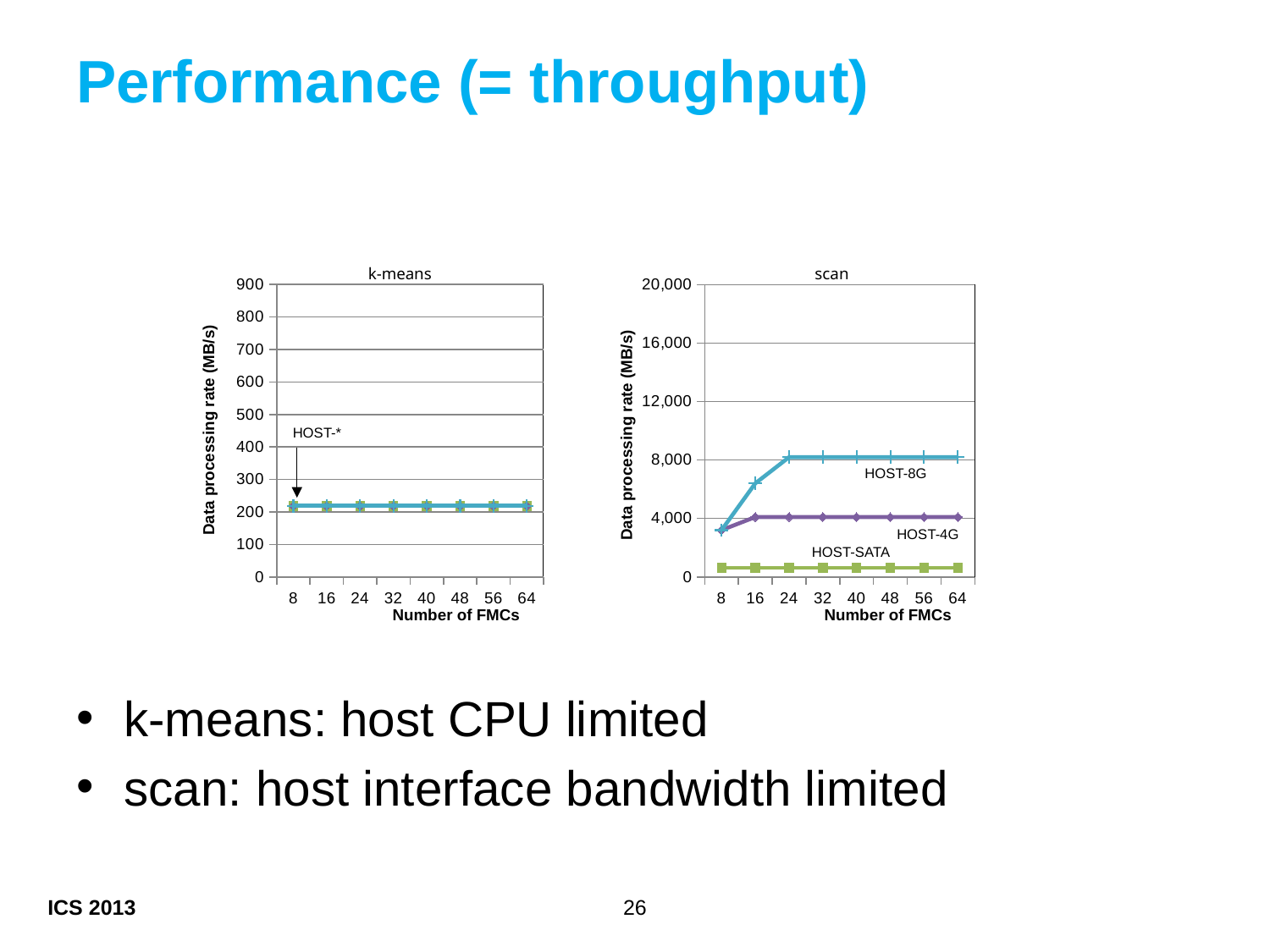
What kind of chart is the scan chart? line chart In the scan chart, which series has the highest data processing rate at 64 FMCs? HOST-8G In the k-means chart, is the data processing rate at 64 FMCs greater or less than 300? less What is the label on the y axis of the scan chart? Data processing rate (MB/s) In the scan chart, which is larger at 40 FMCs: HOST-4G or HOST-SATA? HOST-4G In the scan chart, how many series are plotted? 3 In the scan chart, is the value for HOST-8G at 8 FMCs greater or less than 4,000? less What kind of chart is the k-means chart? line chart In the scan chart, is the value for HOST-8G at 64 FMCs greater or less than 4,000? greater How many Number of FMCs values are plotted along the x axis of the k-means chart? 8 In the scan chart, which series has the lowest data processing rate? HOST-SATA